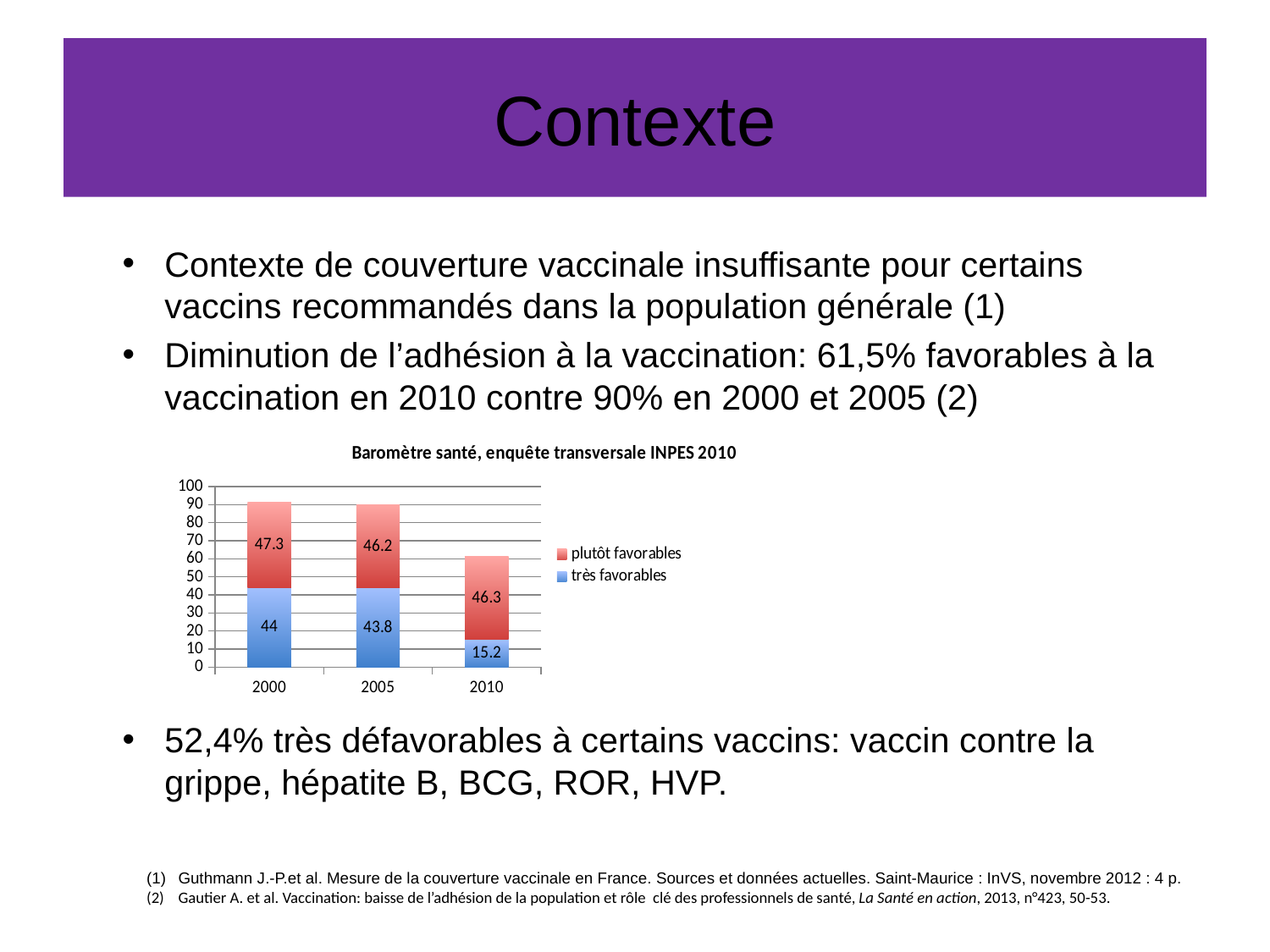
Which is larger: the "très favorables" value in 2000 or in 2005? 2000 What is the difference between the "très favorables" values for 2005 and 2010? 28.6 What is the value for "plutôt favorables" in 2005? 46.2 What kind of chart is shown on the slide? Stacked bar chart What is the value for "très favorables" in 2010? 15.2 What is the total of the stacked bar for 2005? 90 What is the total of the stacked bar for 2010? 61.5 Which year has the highest value for "plutôt favorables"? 2000 How many series does the legend list? 2 How many years are shown on the x axis? 3 Which year has the lowest value for "très favorables"? 2010 What is the value for "très favorables" in 2000? 44